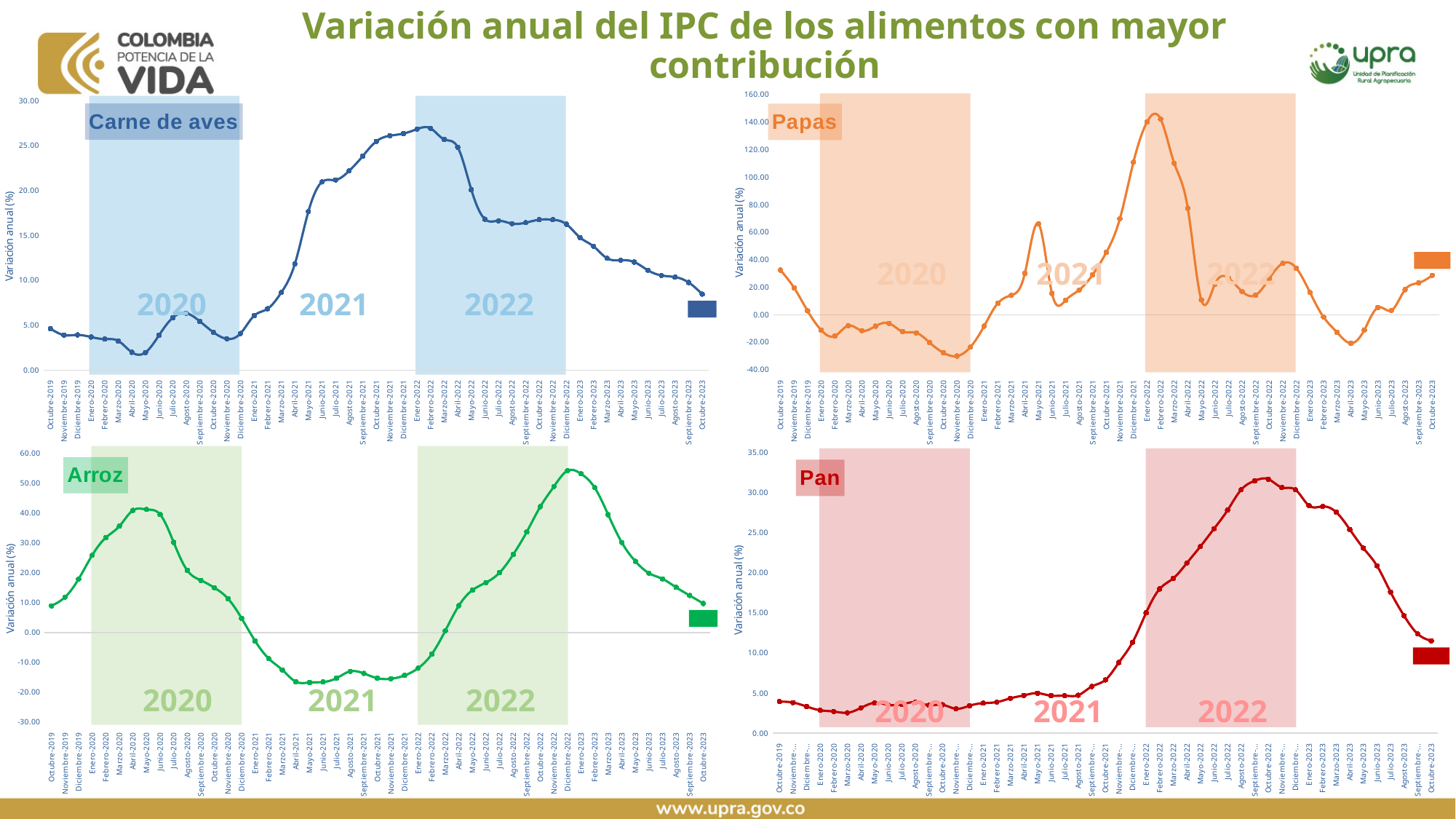
Which of the four charts on the slide is drawn in green? Arroz In the Papas chart, is the value for Abril-2023 greater or less than 0.00? less In the Arroz chart, is the value for Diciembre-2022 greater or less than 50.00? greater In the Carne de aves chart, is the value for Febrero-2022 greater or less than 25.00? greater What kind of chart is the Carne de aves chart? line chart In the Pan chart, do the values rise or fall from Enero-2022 to Octubre-2022? rise In the Carne de aves chart, do the values rise or fall from Febrero-2022 to Octubre-2023? fall In the Arroz chart, which is larger, the value for Mayo-2020 or the value for Octubre-2023? Mayo-2020